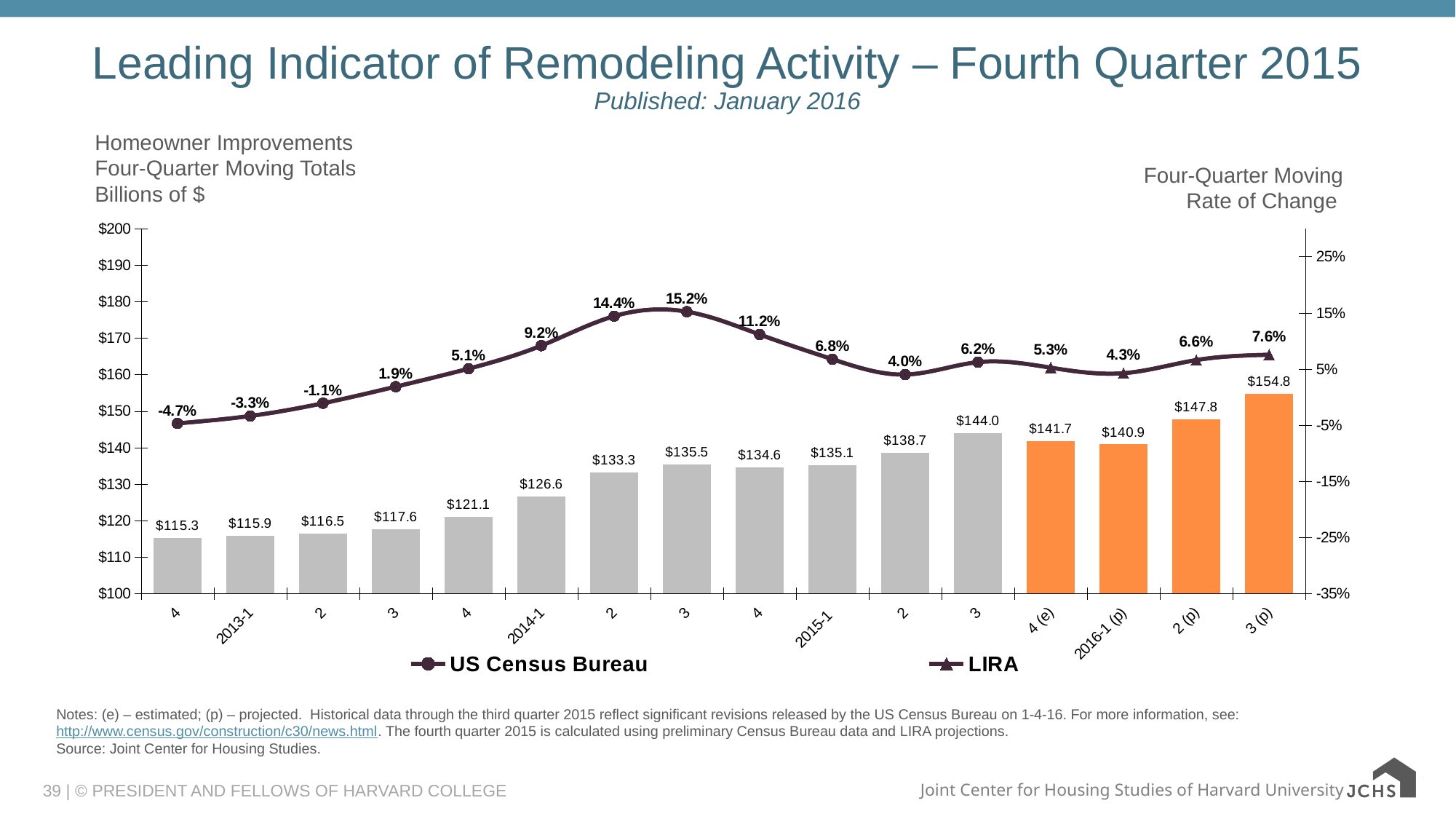
What is the difference between the four-quarter moving totals for 3 (p) and 2 (p) of 2016? $7.0 What is the four-quarter moving total for 2015-1? $135.1 Which quarter has the lowest four-quarter moving total? 4 (2012), $115.3 Which is larger, the four-quarter moving total for 2015 quarter 3 or for 2015 quarter 4 (e)? 2015 quarter 3 ($144.0) What kind of chart is this? Combination bar and line chart What are the two series named in the legend? US Census Bureau and LIRA Which quarter has the highest four-quarter moving total? 3 (p) (2016), $154.8 What is the lowest four-quarter moving rate of change shown on the line? -4.7% Do the four-quarter moving totals generally rise or fall from 2012 quarter 4 to 2016 quarter 3 (p)? Rise What is the four-quarter moving rate of change shown for the third quarter of 2014? 15.2% How many bars (quarters) are plotted in the chart? 16 How many series does the legend list? 2